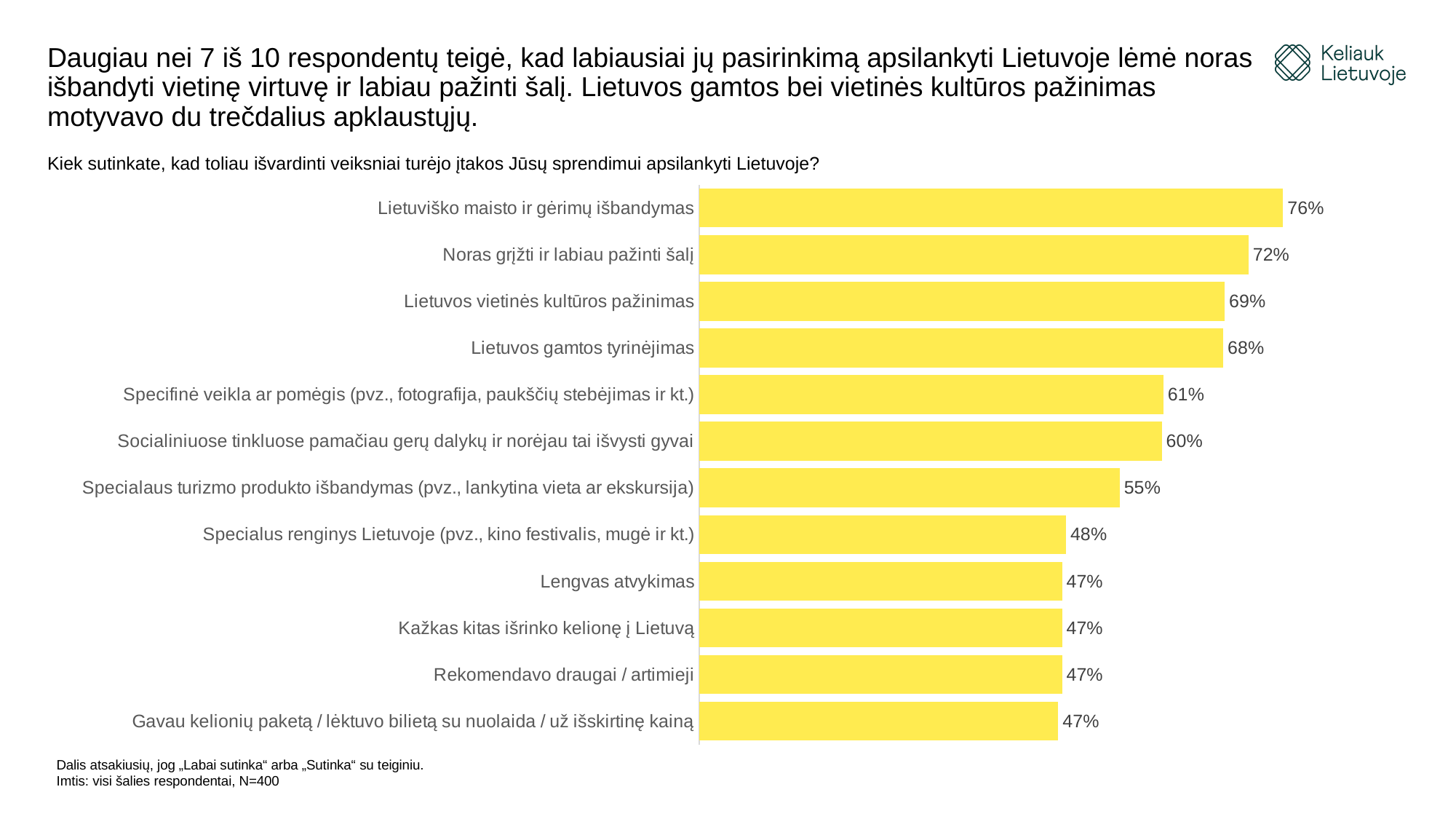
What colour are the bars in the chart? Yellow What is the value for "Lietuviško maisto ir gėrimų išbandymas"? 76% How many categories are shown in the chart? 12 What is the value for "Lengvas atvykimas"? 47% What is the difference between the values for "Lietuviško maisto ir gėrimų išbandymas" and "Noras grįžti ir labiau pažinti šalį"? 4% How many categories have a value of 47%? 4 What kind of chart is shown on the slide? Bar chart What is the difference between the values for "Specifinė veikla ar pomėgis (pvz., fotografija, paukščių stebėjimas ir kt.)" and "Specialus renginys Lietuvoje (pvz., kino festivalis, mugė ir kt.)"? 13% What is the value for "Specialaus turizmo produkto išbandymas (pvz., lankytina vieta ar ekskursija)"? 55% Which is larger: the value for "Lietuvos vietinės kultūros pažinimas" or the value for "Socialiniuose tinkluose pamačiau gerų dalykų ir norėjau tai išvysti gyvai"? Lietuvos vietinės kultūros pažinimas What is the value for "Lietuvos gamtos tyrinėjimas"? 68% Which category has the highest value? Lietuviško maisto ir gėrimų išbandymas